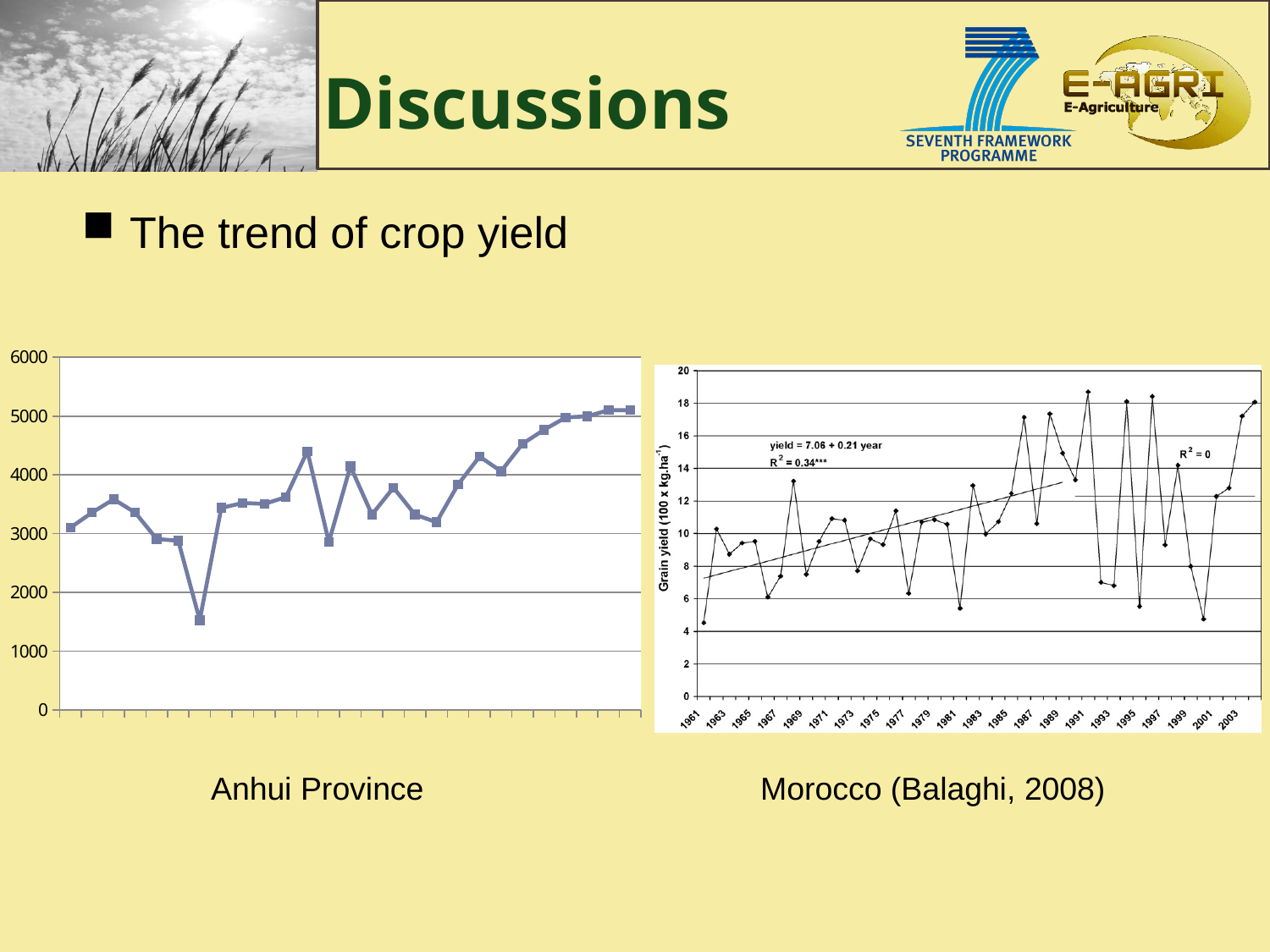
In the Anhui Province chart, is the lowest point greater or less than 2000? less In the Morocco (Balaghi, 2008) chart, what is the first year shown on the x axis? 1961 In the Morocco (Balaghi, 2008) chart, which year has the larger value, 1991 or 1993? 1991 What kind of chart is the Anhui Province chart on the left? line chart In the Morocco (Balaghi, 2008) chart, does the fitted trend line over 1961-1990 rise or fall over time? rise In the Morocco (Balaghi, 2008) chart, what is the y-axis label? Grain yield (100 x kg.ha-1) In the Morocco (Balaghi, 2008) chart, is the value for 1969 greater or less than 12? greater In the Anhui Province chart, do the values overall rise or fall from left to right? rise What kind of chart is the Morocco (Balaghi, 2008) chart on the right? line chart In the Anhui Province chart, is the last point on the right greater or less than 5000? greater